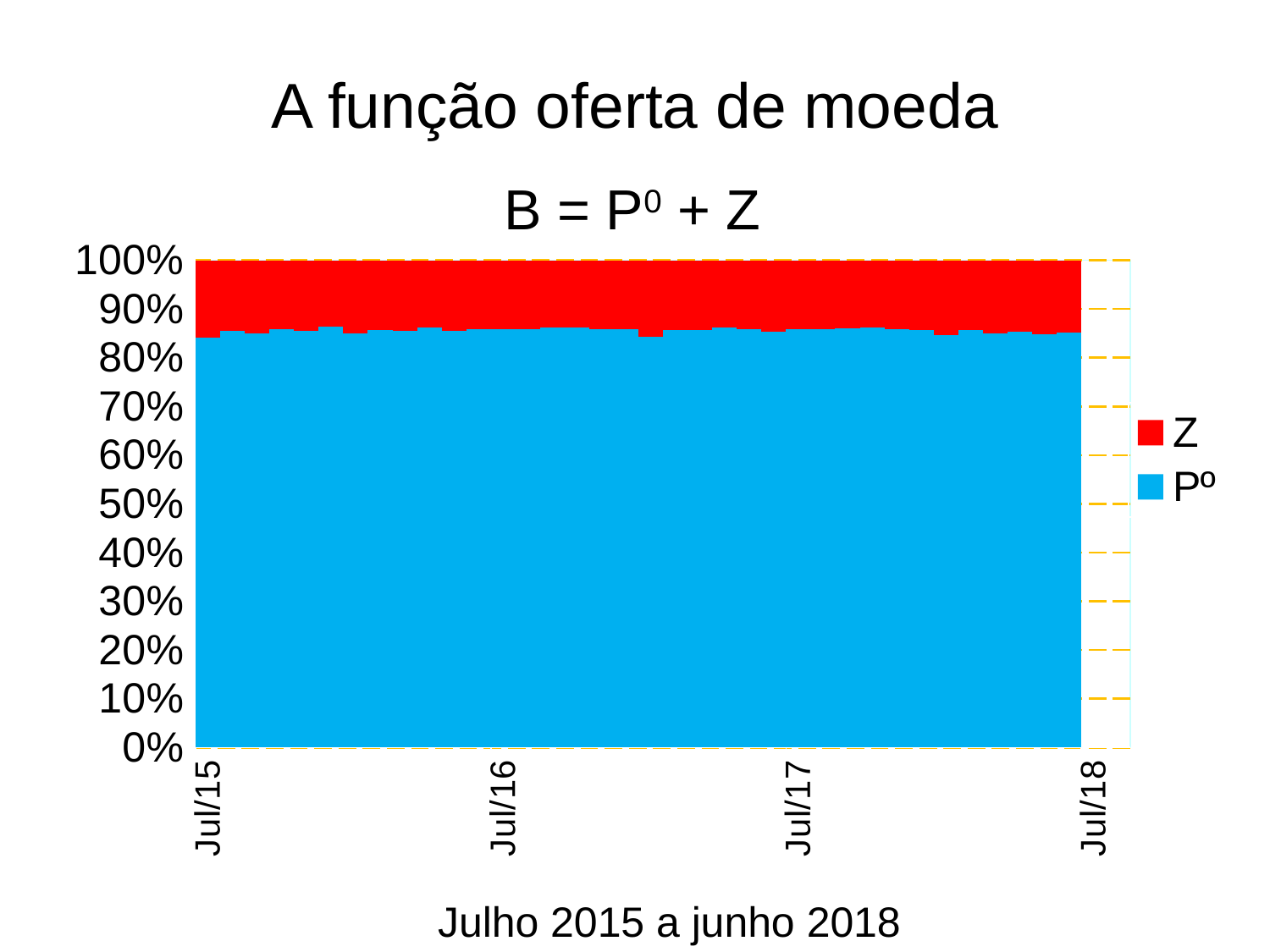
How many series does the chart's legend list? 2 What are the two series named in the chart's legend? Z and Pº What is the highest value shown on the chart's vertical axis? 100% Is the share of Z in Jul/16 greater or less than 20%? less Which series, Pº or Z, accounts for the larger share of the total in Jul/15? Pº Does the share of Pº rise, fall, or stay roughly flat from Jul/15 to Jul/18? Stays roughly flat What kind of chart is shown on the slide? Stacked bar chart Is the share of Pº in Jul/15 greater or less than 80%? greater Is the share of Pº in Jul/17 greater or less than 90%? less What colour represents the series Z in the chart? Red